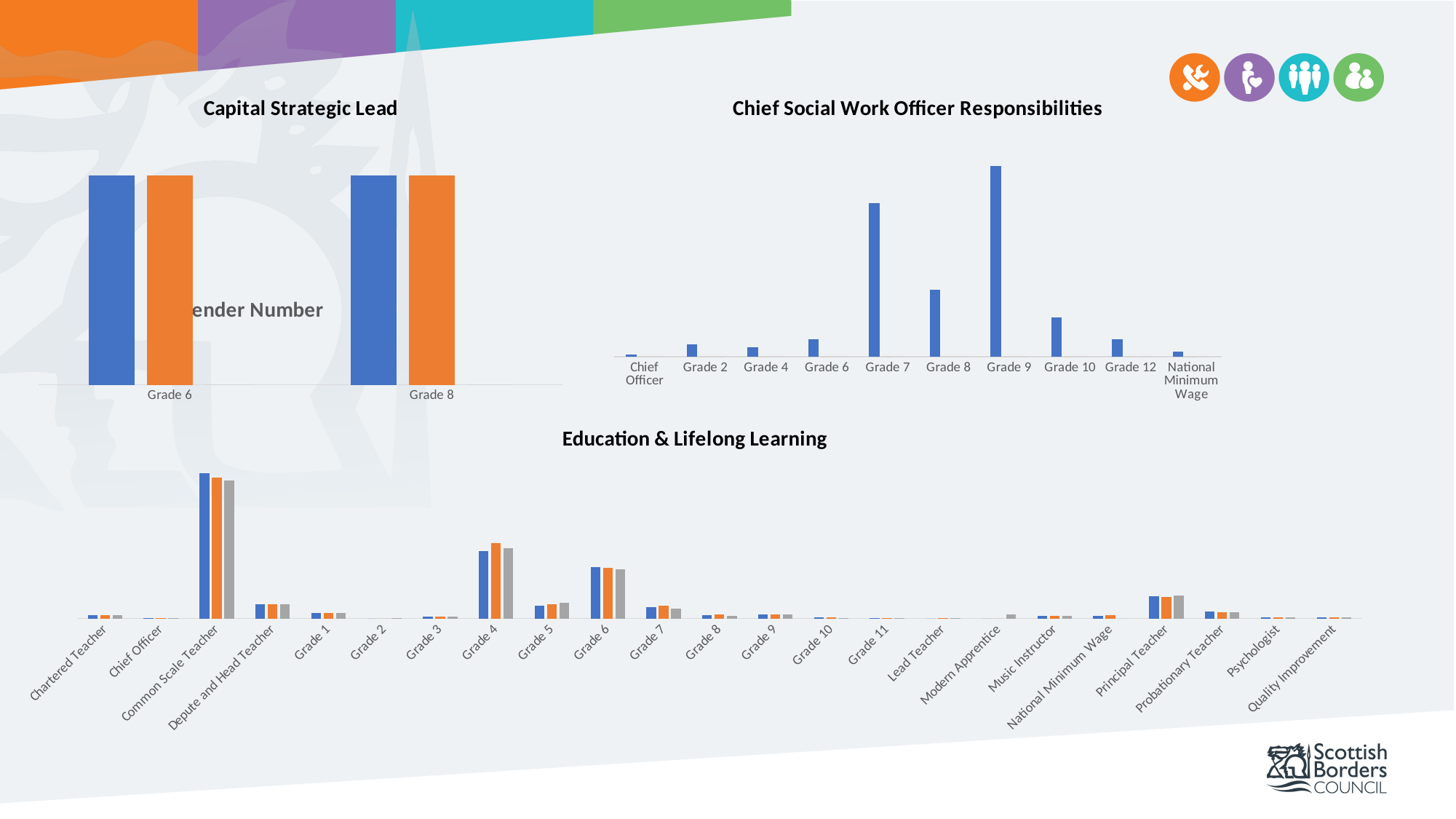
In the Chief Social Work Officer Responsibilities chart, which is larger, Grade 7 or Grade 8? Grade 7 In the Chief Social Work Officer Responsibilities chart, which grade has the highest value? Grade 9 How many categories are shown on the x axis of the Capital Strategic Lead chart? 2 How many categories are shown on the x axis of the Education & Lifelong Learning chart? 23 What kind of chart is the Chief Social Work Officer Responsibilities chart? Bar chart In the Chief Social Work Officer Responsibilities chart, which is larger, Grade 10 or Grade 12? Grade 10 How many categories are shown on the x axis of the Chief Social Work Officer Responsibilities chart? 10 In the Education & Lifelong Learning chart, which category has the highest values? Common Scale Teacher What kind of chart is the Capital Strategic Lead chart? Bar chart How many bars (series) are plotted for each category in the Education & Lifelong Learning chart? 3 In the Education & Lifelong Learning chart, which category has larger values, Grade 4 or Principal Teacher? Grade 4